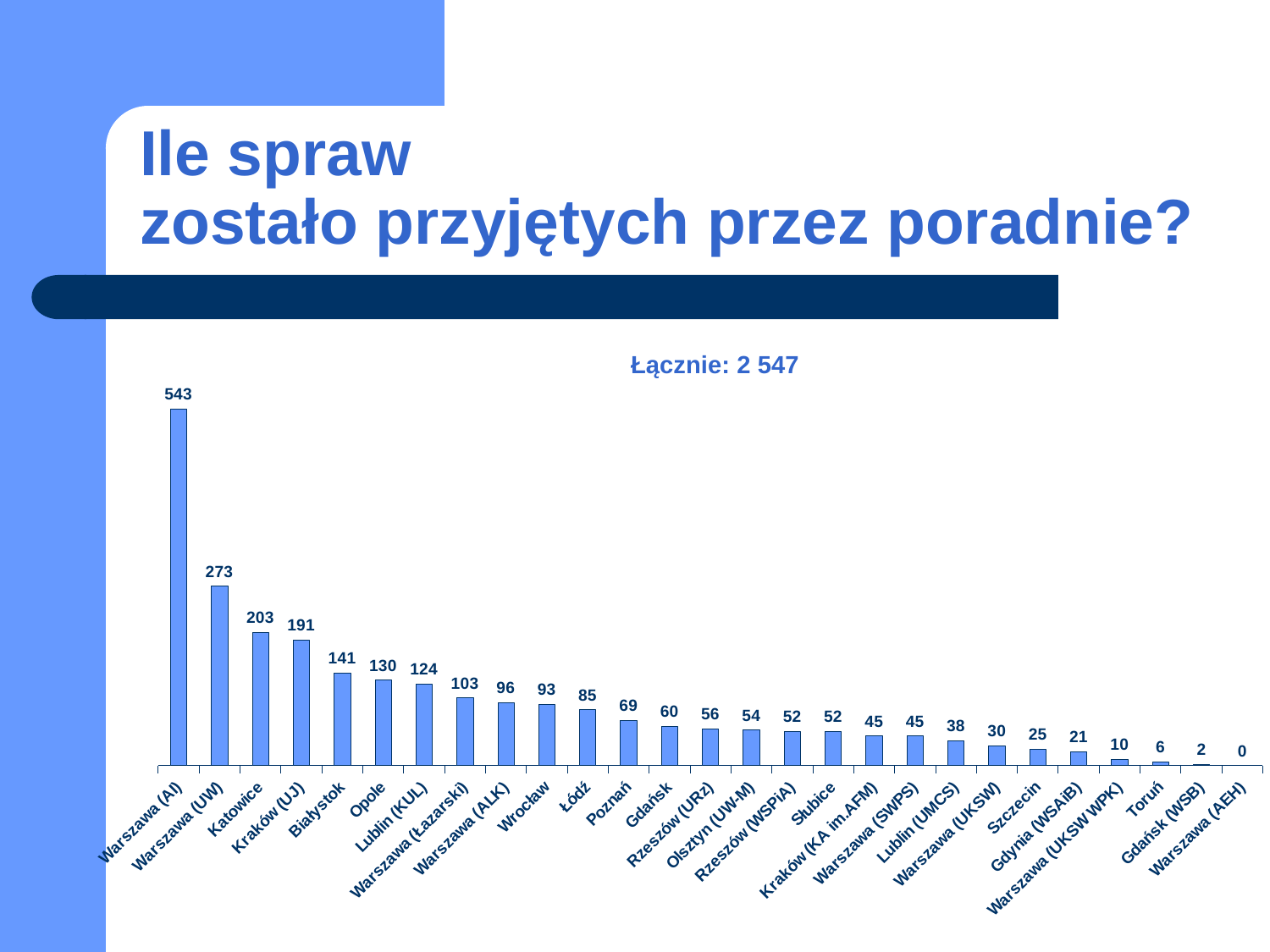
What is the difference between the values for Warszawa (AI) and Warszawa (UW)? 270 What is the value shown for Białystok? 141 Which category has the lowest value in the chart? Warszawa (AEH) What kind of chart is shown on the slide? bar chart Which category has the highest value in the chart? Warszawa (AI) What is the difference between the values for Katowice and Kraków (UJ)? 12 Which has a larger value, Opole or Lublin (KUL)? Opole How many cases does the chart show for Warszawa (UW)? 273 What total is printed above the chart (Łącznie)? 2 547 How many categories are shown on the x axis of the chart? 27 Which has a larger value, Poznań or Gdańsk? Poznań What is the value shown for Lublin (UMCS)? 38